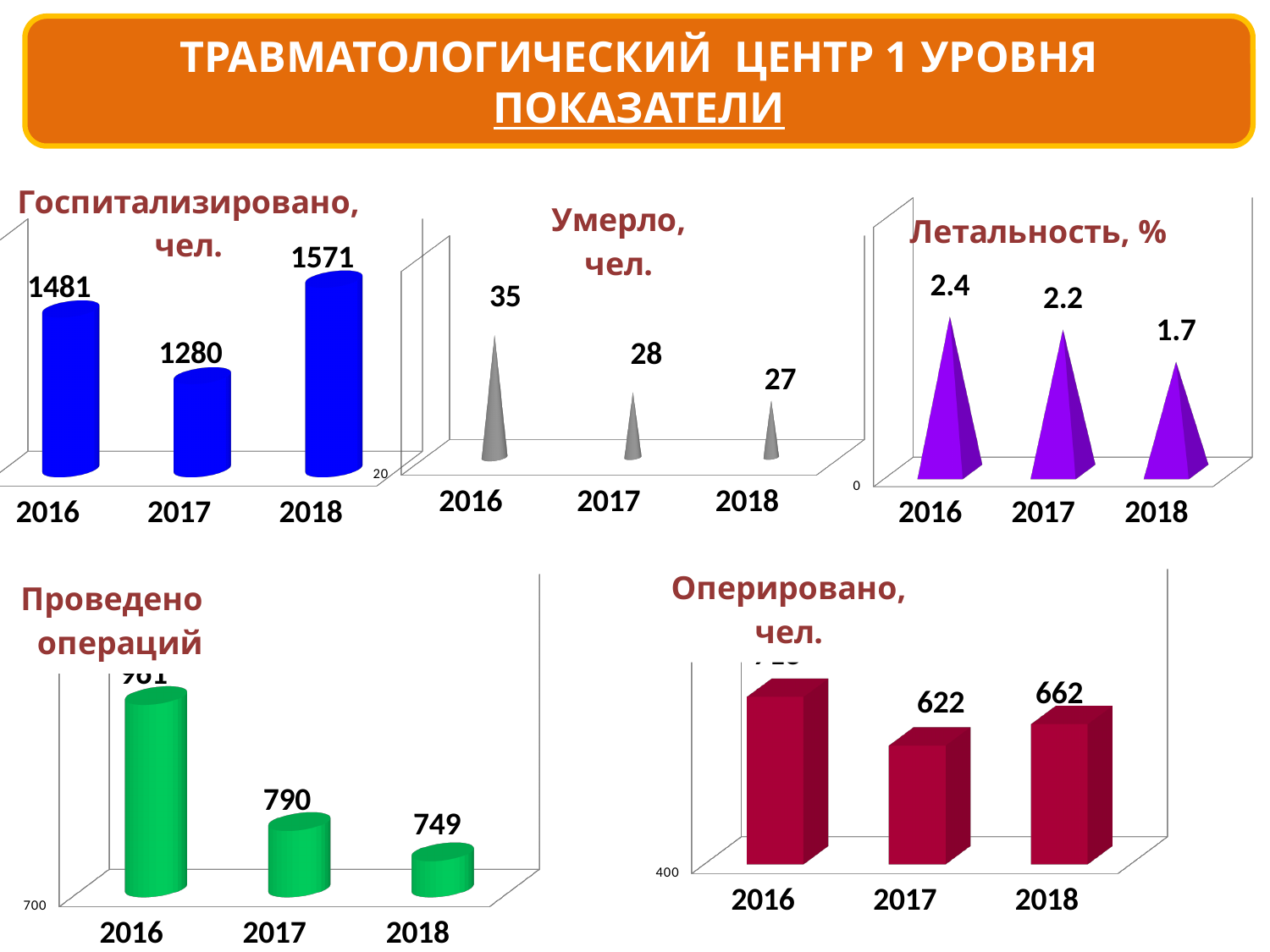
In the chart titled "Летальность, %", which year has the highest value? 2016 In the chart titled "Госпитализировано, чел.", which year has the lowest value? 2017 In the chart titled "Оперировано, чел.", which is larger, the value for 2017 or the value for 2018? 2018 In the chart titled "Госпитализировано, чел.", what is the value for 2018? 1571 In the chart titled "Умерло, чел.", do the values rise or fall from 2016 to 2018? fall In the chart titled "Умерло, чел.", what is the value for 2016? 35 In the chart titled "Госпитализировано, чел.", what is the difference between the 2018 and 2016 values? 90 In the chart titled "Летальность, %", what is the difference between the 2016 and 2017 values? 0.2 How many years are shown on the x axis of the chart titled "Оперировано, чел."? 3 In the chart titled "Летальность, %", what is the value for 2018? 1.7 In the chart titled "Проведено операций", which year has the highest value? 2016 In the chart titled "Проведено операций", what is the value for 2017? 790